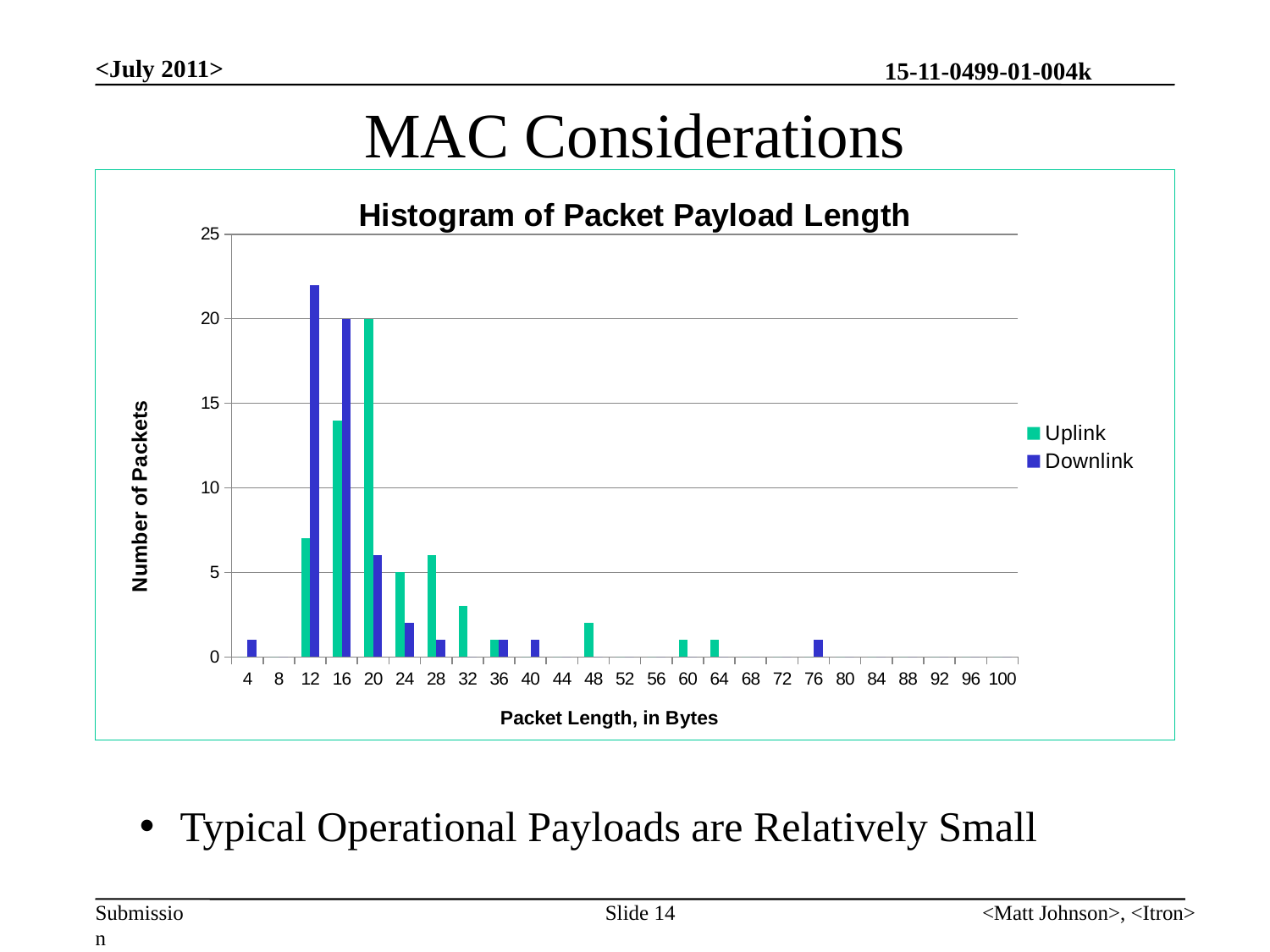
Is the Downlink value at packet length 12 greater or less than 20? greater At packet length 16, which series has the larger value, Uplink or Downlink? Downlink What is the title of the chart? Histogram of Packet Payload Length How many series does the legend list? 2 What is the Downlink value at packet length 16? 20 What kind of chart is shown on the slide? bar chart Is the Uplink value at packet length 16 greater or less than 15? less What is the Uplink value at packet length 20? 20 How many packet length categories are shown on the x axis? 25 What is the Uplink value at packet length 24? 5 At which packet length is the Uplink series highest? 20 At which packet length is the Downlink series highest? 12